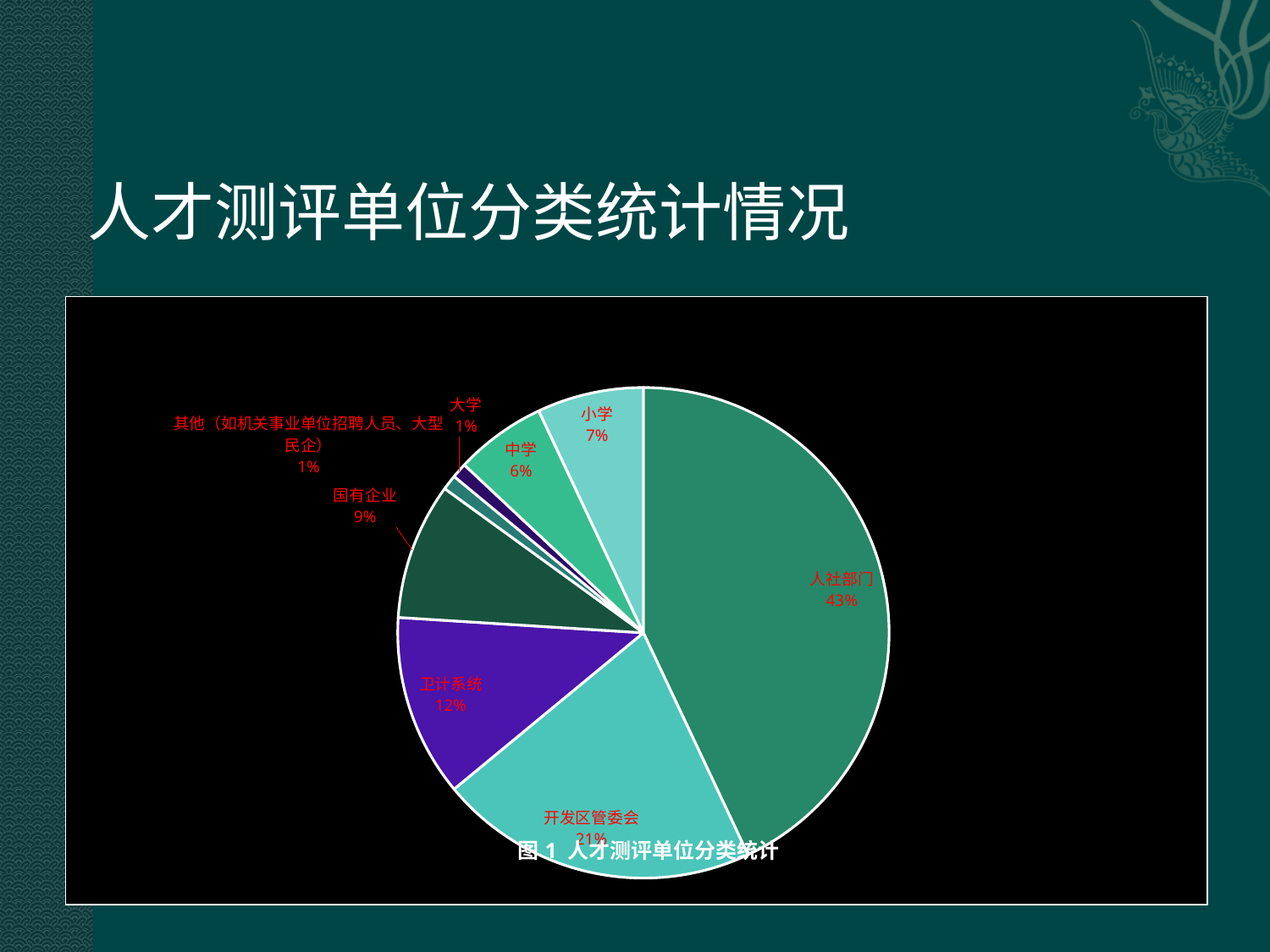
What is the difference in percentage points between 人社部门 and 开发区管委会? 22 How many slices does the pie chart have? 8 What share of the pie does 人社部门 account for? 43% What is the caption printed below the pie chart? 图1 人才测评单位分类统计 What is the value shown for 开发区管委会? 21% What is the value shown for 小学? 7% What is the value shown for 卫计系统? 12% What is the value shown for 国有企业? 9% What kind of chart is shown on the slide? pie chart Which category has the largest slice of the pie? 人社部门 Which is larger, the slice for 中学 or the slice for 小学? 小学 What is the value shown for 大学? 1%